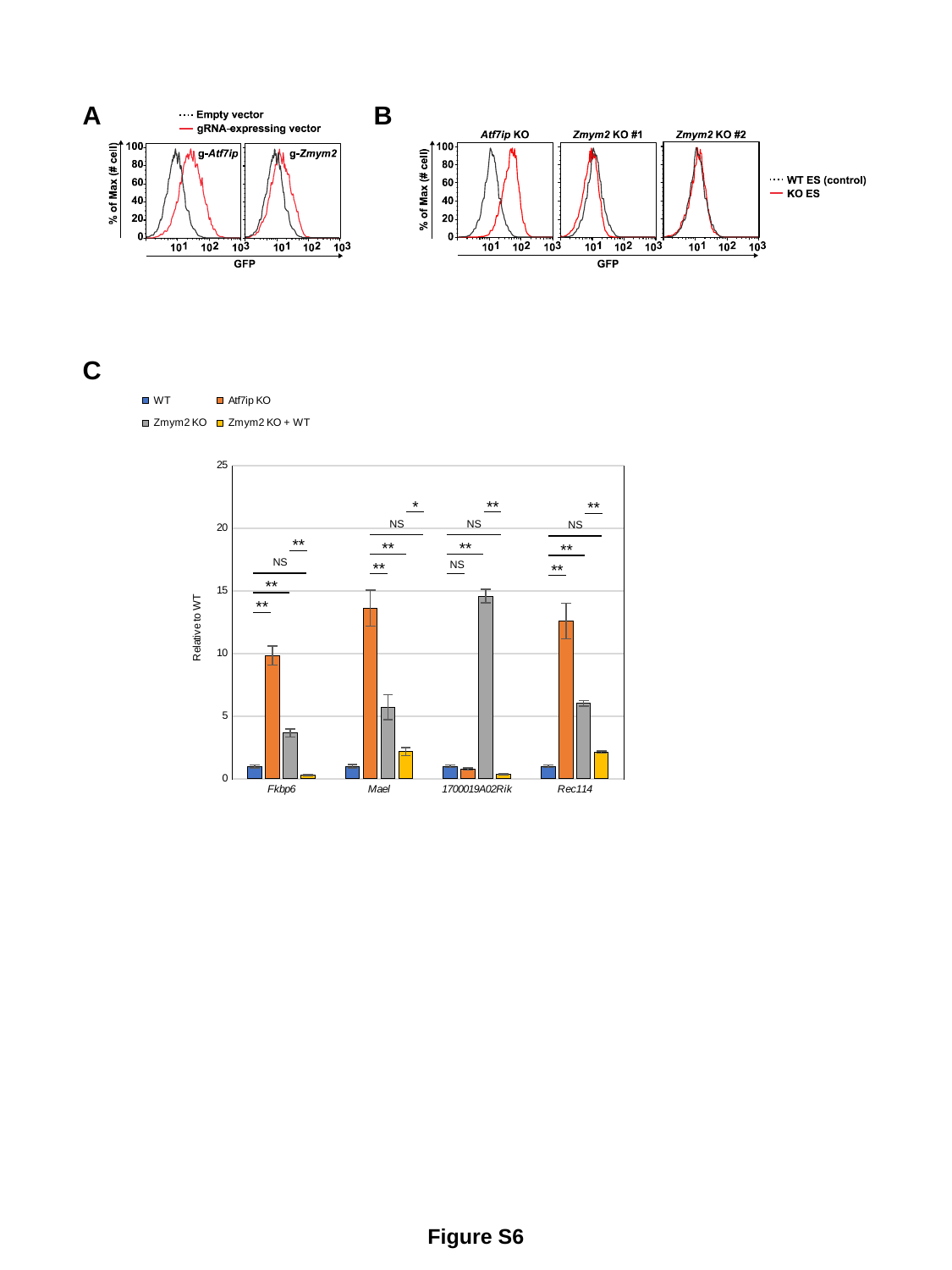
In panel C, which series has the lowest value for Fkbp6? Zmym2 KO + WT In panel C, is the value for Zmym2 KO at Fkbp6 greater or less than 5? less In panel C, is the value for Atf7ip KO at Mael greater or less than 10? greater In panel C, which series has the highest value for Rec114? Atf7ip KO In panel C, is the value for Zmym2 KO at 1700019A02Rik greater or less than 10? greater In panel C, what kind of chart is shown? bar chart In panel C, what is the label of the y axis? Relative to WT In panel C, how many gene categories are shown on the x axis? 4 In panel C, for Mael, which is larger: Atf7ip KO or Zmym2 KO? Atf7ip KO In panel C, which series has the highest value for 1700019A02Rik? Zmym2 KO In panel C, how many series does the legend list? 4